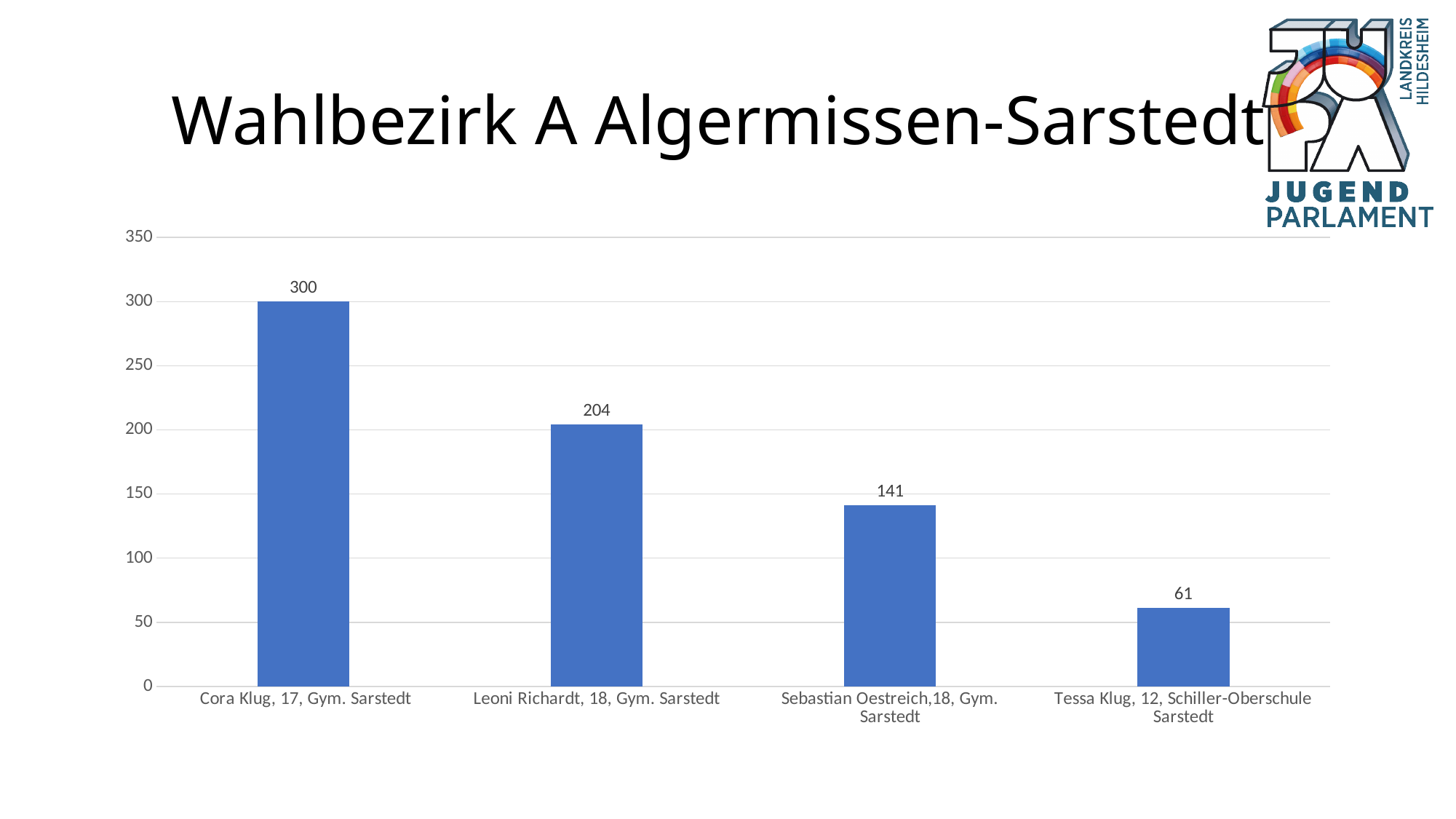
What is the difference between the values for Sebastian Oestreich and Tessa Klug? 80 Which candidate has the highest value? Cora Klug, 17, Gym. Sarstedt What value is shown for Sebastian Oestreich, 18, Gym. Sarstedt? 141 What kind of chart is shown on the slide? Bar chart What value is shown for Leoni Richardt, 18, Gym. Sarstedt? 204 What value is shown for Cora Klug, 17, Gym. Sarstedt? 300 How many candidates are shown in the chart? 4 Which candidate has the lowest value? Tessa Klug, 12, Schiller-Oberschule Sarstedt What value is shown for Tessa Klug, 12, Schiller-Oberschule Sarstedt? 61 Which is larger, the value for Leoni Richardt or the value for Sebastian Oestreich? Leoni Richardt What is the difference between the values for Cora Klug and Leoni Richardt? 96 Do the values rise or fall from left to right along the x axis? Fall